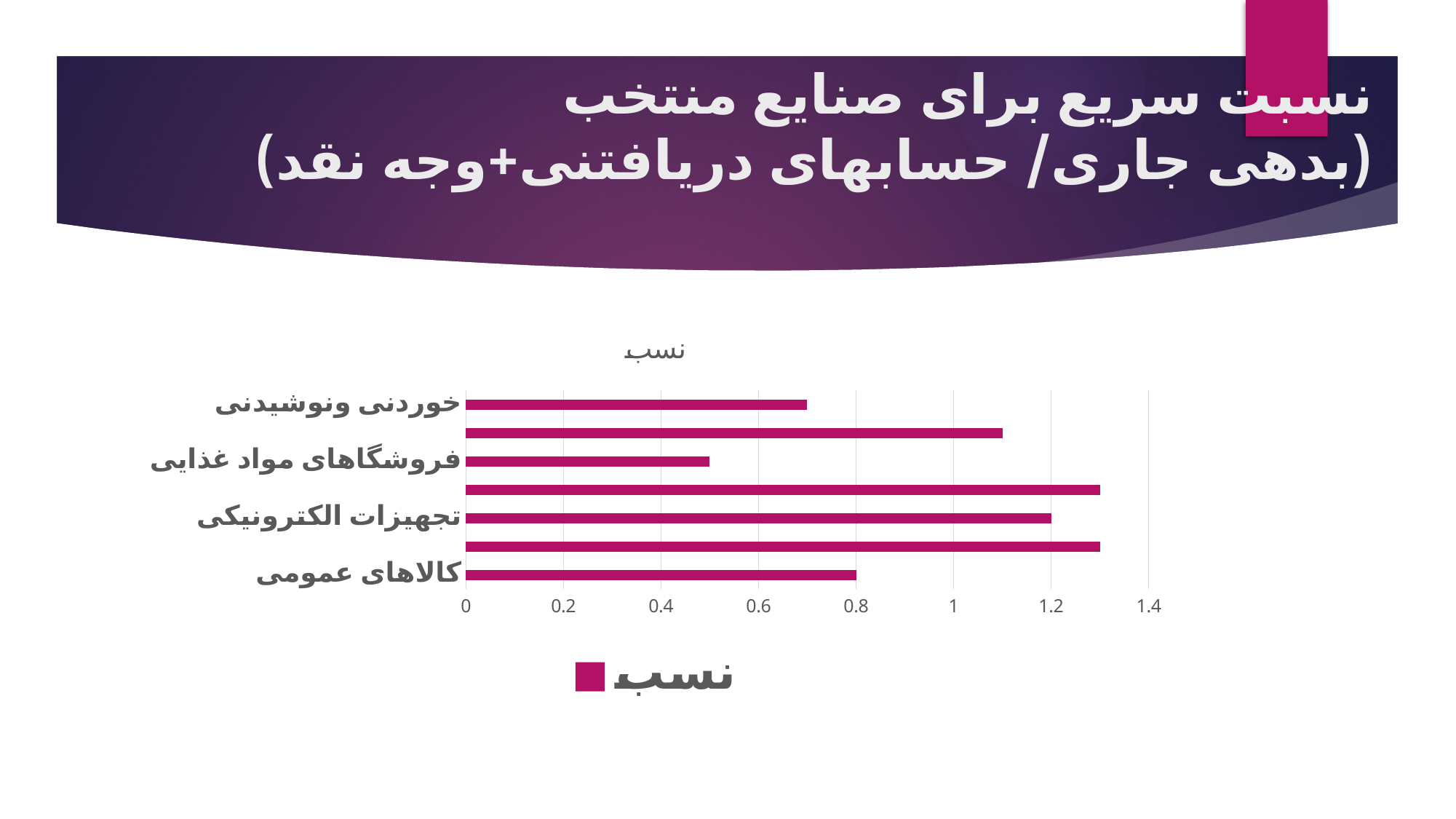
Is the value for خوردنی ونوشیدنی greater or less than 0.6? greater Is the value for خوردنی ونوشیدنی greater or less than 0.8? less Is the value for کالاهای عمومی greater or less than 1? less What is the legend entry of the chart? نسب Which has the larger value, کالاهای عمومی or خوردنی ونوشیدنی? کالاهای عمومی How many bars are plotted in the chart? 7 How many series does the legend list? 1 What kind of chart is shown on the slide? Bar chart Which labelled category has the lowest value? فروشگاه‌های مواد غذایی Which has the larger value, تجهیزات الکترونیکی or فروشگاه‌های مواد غذایی? تجهیزات الکترونیکی